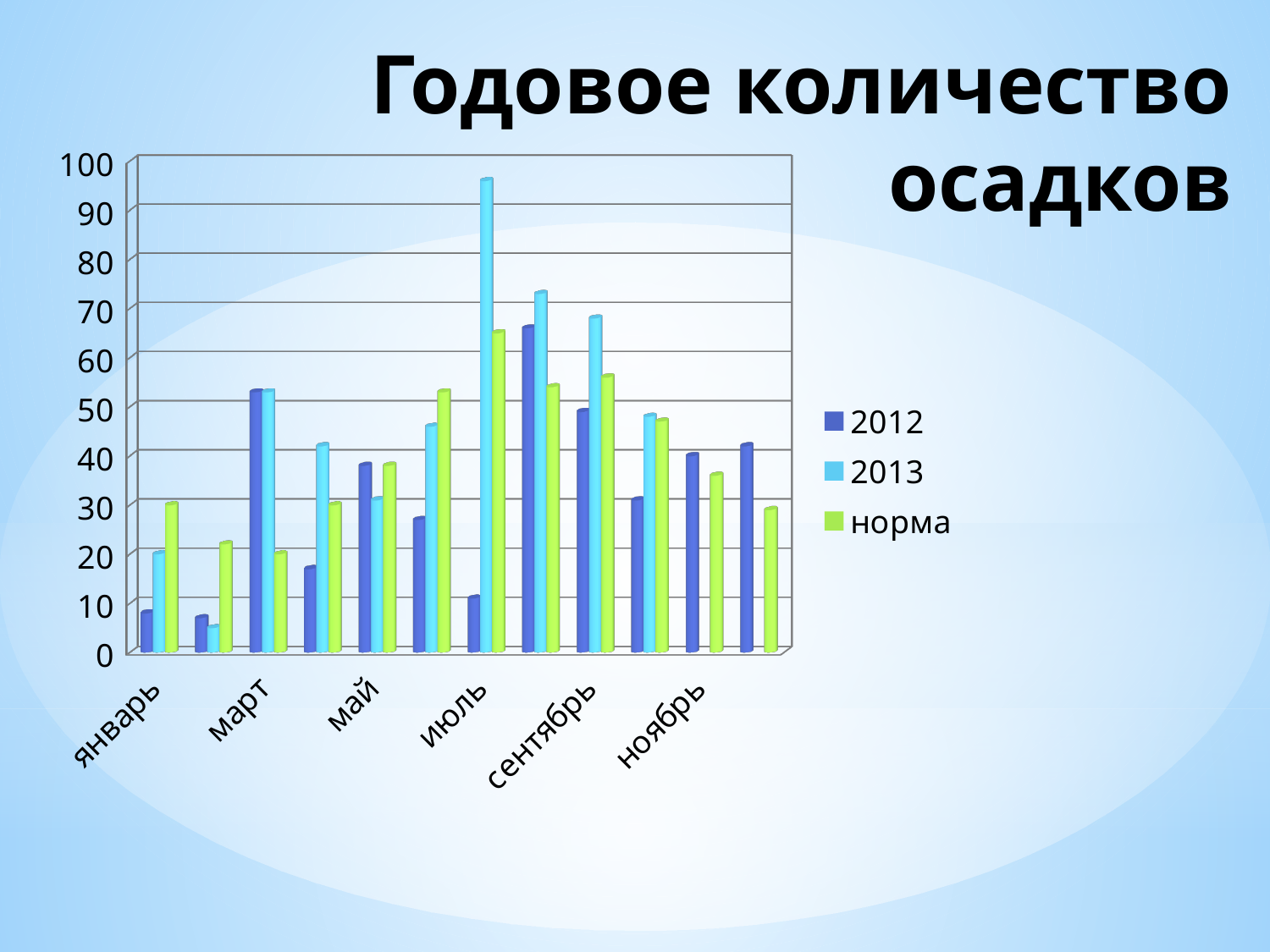
Is the value for норма in март greater or less than 30? less Is the value for 2012 in март greater or less than 40? greater In январь, which is larger: the 2013 value or the норма value? норма What kind of chart is shown on the slide? bar chart How many month labels are shown on the x axis? 6 Is the value for 2013 in июль greater or less than 90? greater In июль, which is larger: the 2012 value or the 2013 value? 2013 What is the title of the slide containing the chart? Годовое количество осадков Which month has the highest value for the 2013 series? июль What are the series names listed in the legend? 2012, 2013, норма How many series does the legend list? 3